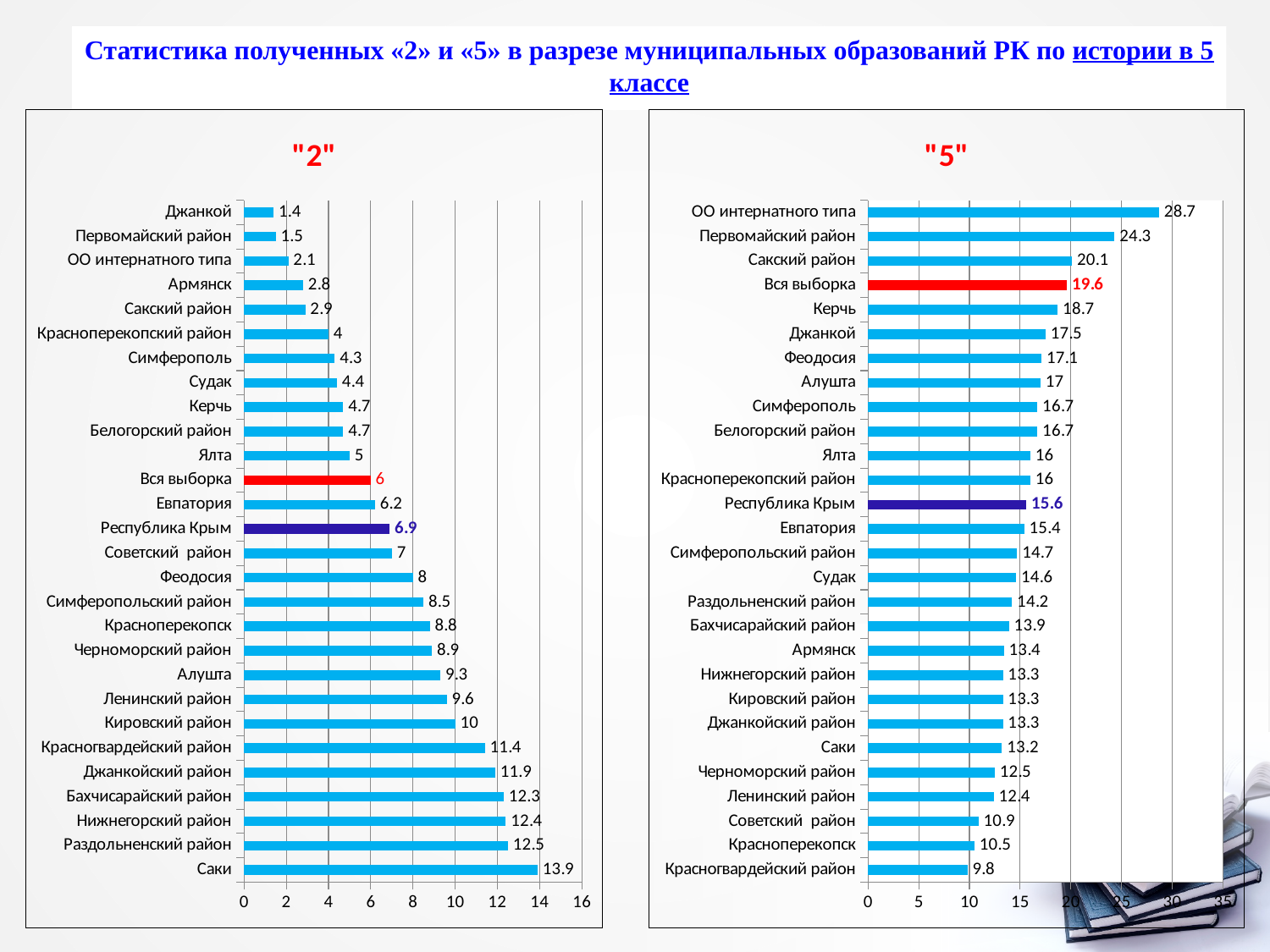
In the "5" chart, what is the value for ОО интернатного типа? 28.7 In the "2" chart, which is larger: the value for Евпатория or the value for Ялта? Евпатория In the "2" chart, what is the value for Республика Крым? 6.9 In the "2" chart, which category has the lowest value? Джанкой In the "5" chart, what is the value for Вся выборка? 19.6 What type of chart is the "2" chart? Bar chart In the "2" chart, what is the value for Саки? 13.9 In the "5" chart, what colour is the bar for Вся выборка? Red In the "5" chart, what is the difference between the values for Первомайский район and Сакский район? 4.2 In the "5" chart, which category has the lowest value? Красногвардейский район In the "5" chart, how many categories are plotted? 28 In the "2" chart, what is the difference between the values for Саки and Джанкой? 12.5